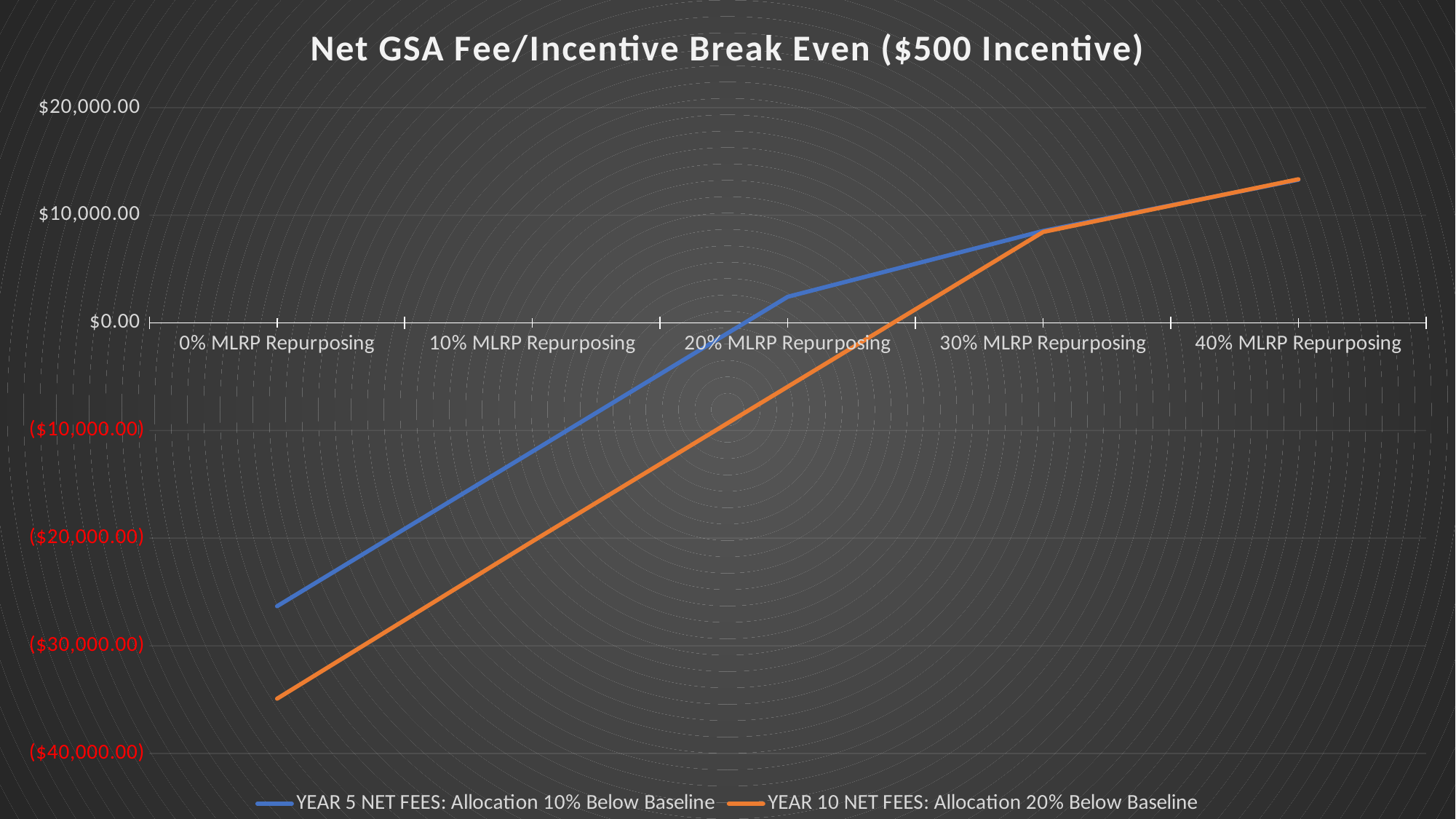
Is the value for YEAR 10 NET FEES at 0% MLRP Repurposing greater or less than ($30,000.00)? less Is the value for YEAR 5 NET FEES at 0% MLRP Repurposing greater or less than ($20,000.00)? less Do the values for YEAR 5 NET FEES rise or fall as MLRP Repurposing increases from 0% to 40%? Rise Is the value for YEAR 5 NET FEES at 20% MLRP Repurposing greater or less than $0.00? greater At 0% MLRP Repurposing, which series has the higher value, YEAR 5 NET FEES or YEAR 10 NET FEES? YEAR 5 NET FEES What kind of chart is shown on the slide? Line chart How many series does the legend list? 2 What is the title of the chart? Net GSA Fee/Incentive Break Even ($500 Incentive) Which series is drawn in orange? YEAR 10 NET FEES: Allocation 20% Below Baseline How many categories are shown on the x axis? 5